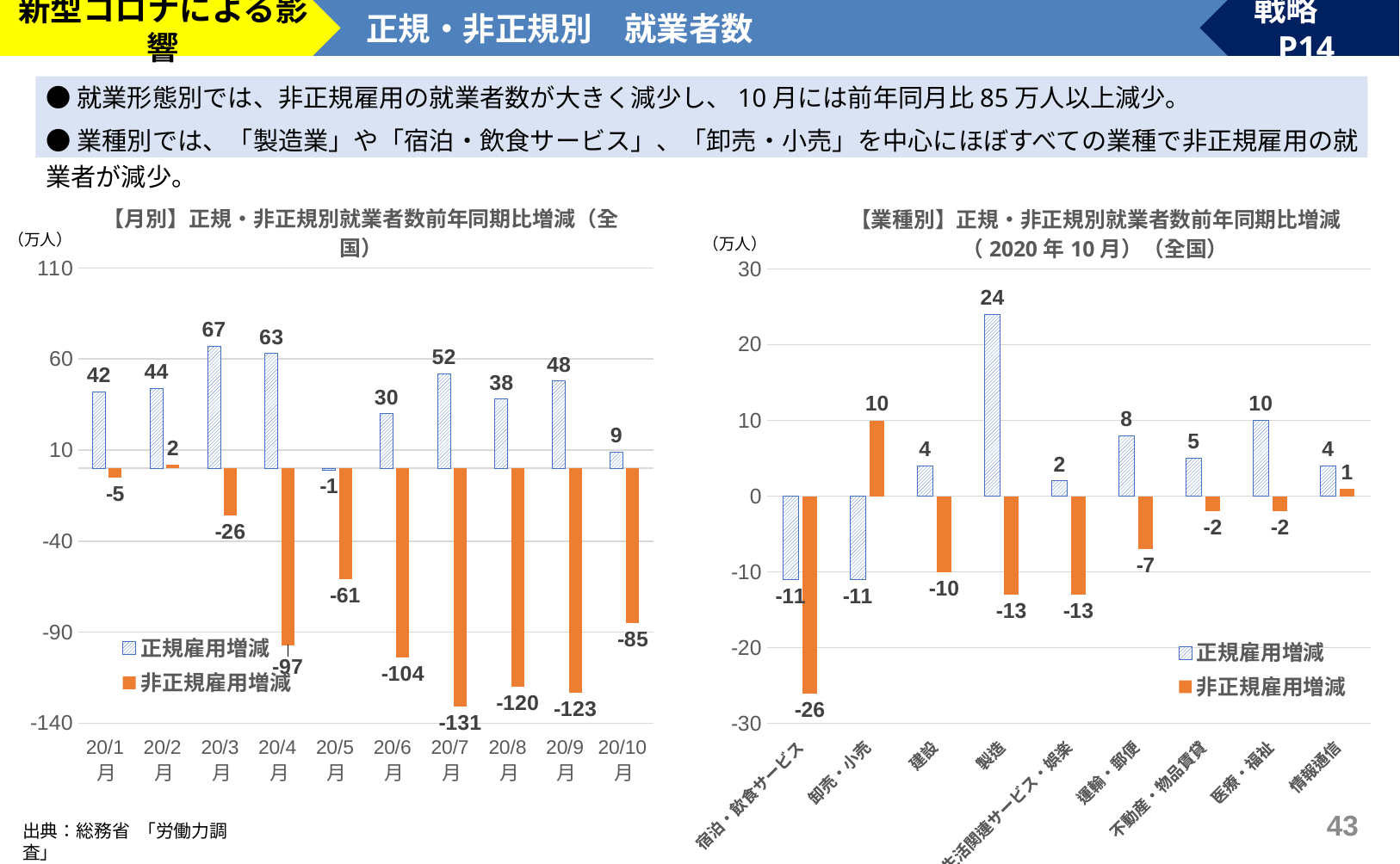
In the right chart (【業種別】), what is the value of 正規雇用増減 for 製造? 24 In the left chart (【月別】), what is the value of 正規雇用増減 for 20/3月? 67 In the left chart (【月別】), what is the difference between the 正規雇用増減 values for 20/3月 and 20/10月? 58 In the right chart (【業種別】), which is larger, the 正規雇用増減 value for 医療・福祉 or for 運輸・郵便? 医療・福祉 In the left chart (【月別】), what kind of chart is used? Bar chart In the left chart (【月別】), which month has the highest 正規雇用増減 value? 20/3月 In the right chart (【業種別】), what is the value of 非正規雇用増減 for 宿泊・飲食サービス? -26 In the right chart (【業種別】), how many series does the legend list? 2 In the left chart (【月別】), how many months are shown on the x axis? 10 In the right chart (【業種別】), which industry has the highest 非正規雇用増減 value? 卸売・小売 In the left chart (【月別】), what is the value of 非正規雇用増減 for 20/10月? -85 In the left chart (【月別】), which month has the lowest 非正規雇用増減 value? 20/7月